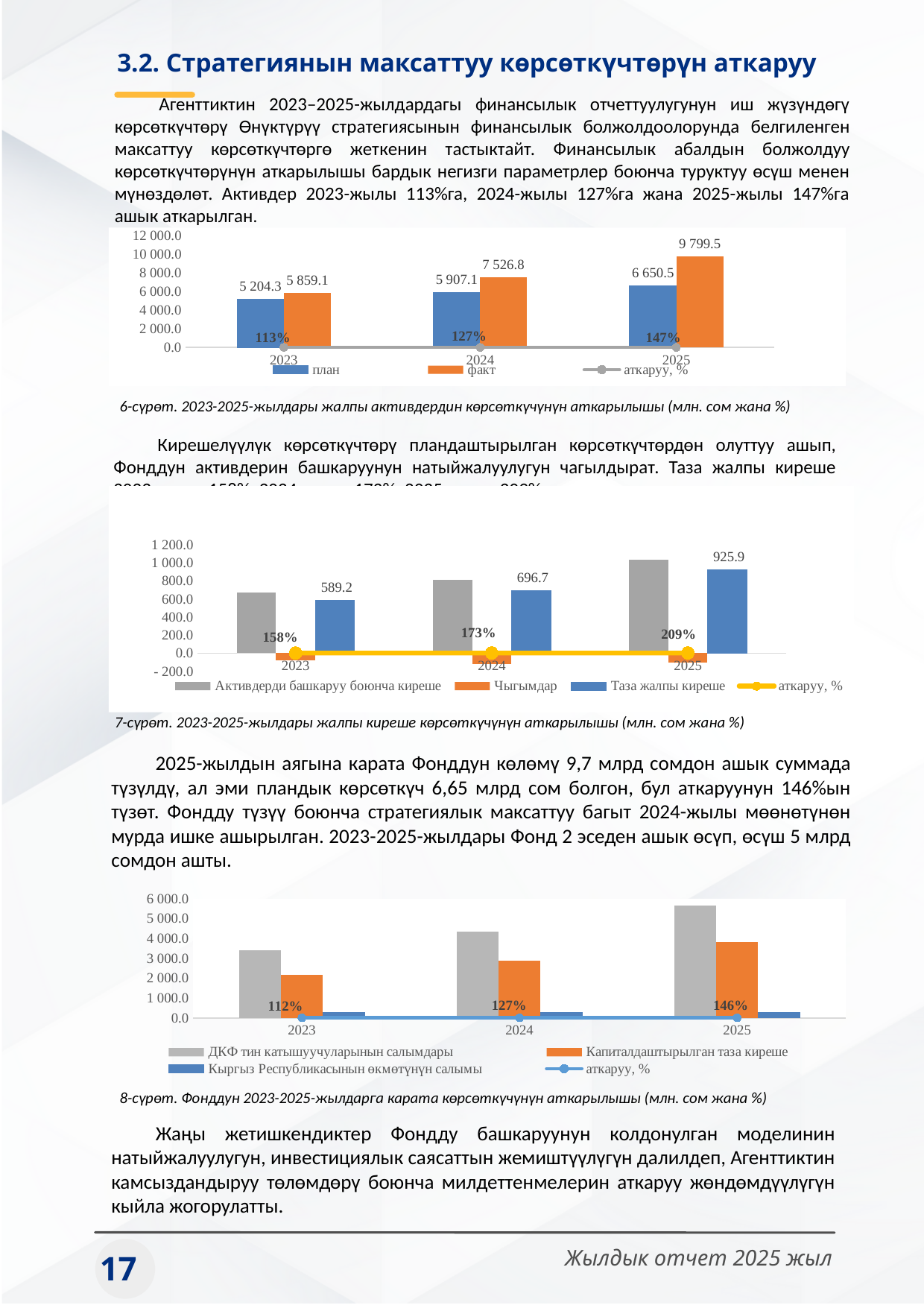
In the top chart (6-сүрөт), what is the difference between факт and план in 2024? 1 619.7 In the top chart (6-сүрөт), how many series does the legend list? 3 In the top chart (6-сүрөт), what is the аткаруу, % value for 2024? 127% In the middle chart (7-сүрөт), what is the value of Таза жалпы киреше for 2024? 696.7 In the top chart (6-сүрөт), which year has the highest факт value? 2025 In the bottom chart (8-сүрөт), is the value of ДКФ тин катышуучуларынын салымдары for 2025 greater or less than 5 000.0? greater In the middle chart (7-сүрөт), what is the аткаруу, % value for 2025? 209% In the bottom chart (8-сүрөт), what is the аткаруу, % value for 2023? 112% In the middle chart (7-сүрөт), does Таза жалпы киреше rise or fall from 2023 to 2025? rise In the top chart (6-сүрөт), what is the value of план for 2023? 5 204.3 In the top chart (6-сүрөт), what is the value of факт for 2025? 9 799.5